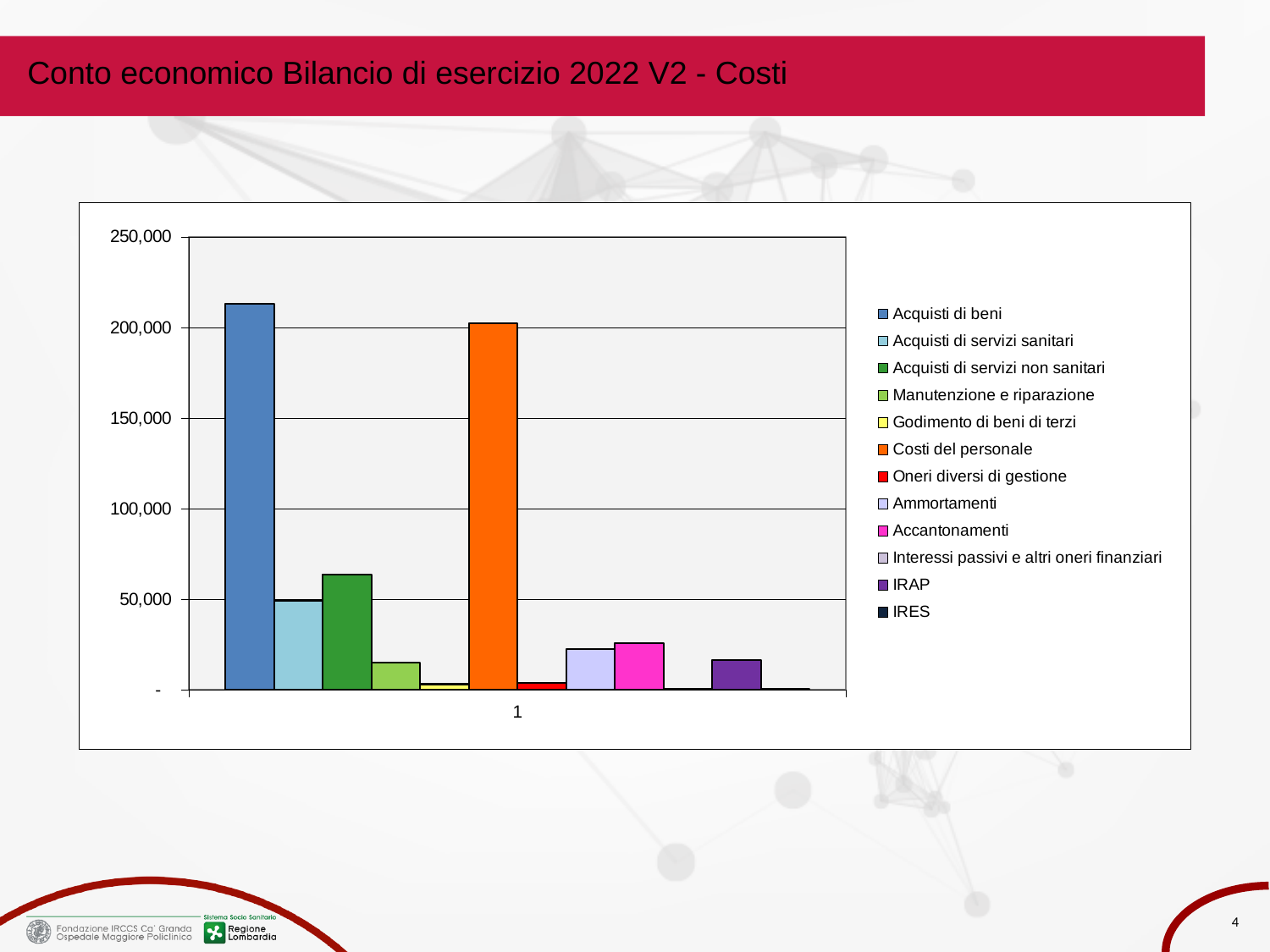
Is the value for Costi del personale greater or less than 150,000? greater Which is larger, Manutenzione e riparazione or Godimento di beni di terzi? Manutenzione e riparazione Which is larger, Acquisti di servizi non sanitari or Acquisti di servizi sanitari? Acquisti di servizi non sanitari Is the value for IRAP greater or less than 50,000? less What is the title of the slide containing the chart? Conto economico Bilancio di esercizio 2022 V2 - Costi Is the value for Ammortamenti greater or less than 50,000? less How many series does the legend list? 12 What colour is the bar for Costi del personale? Orange Which series has the highest value in the chart? Acquisti di beni What kind of chart is shown on the slide? Bar chart